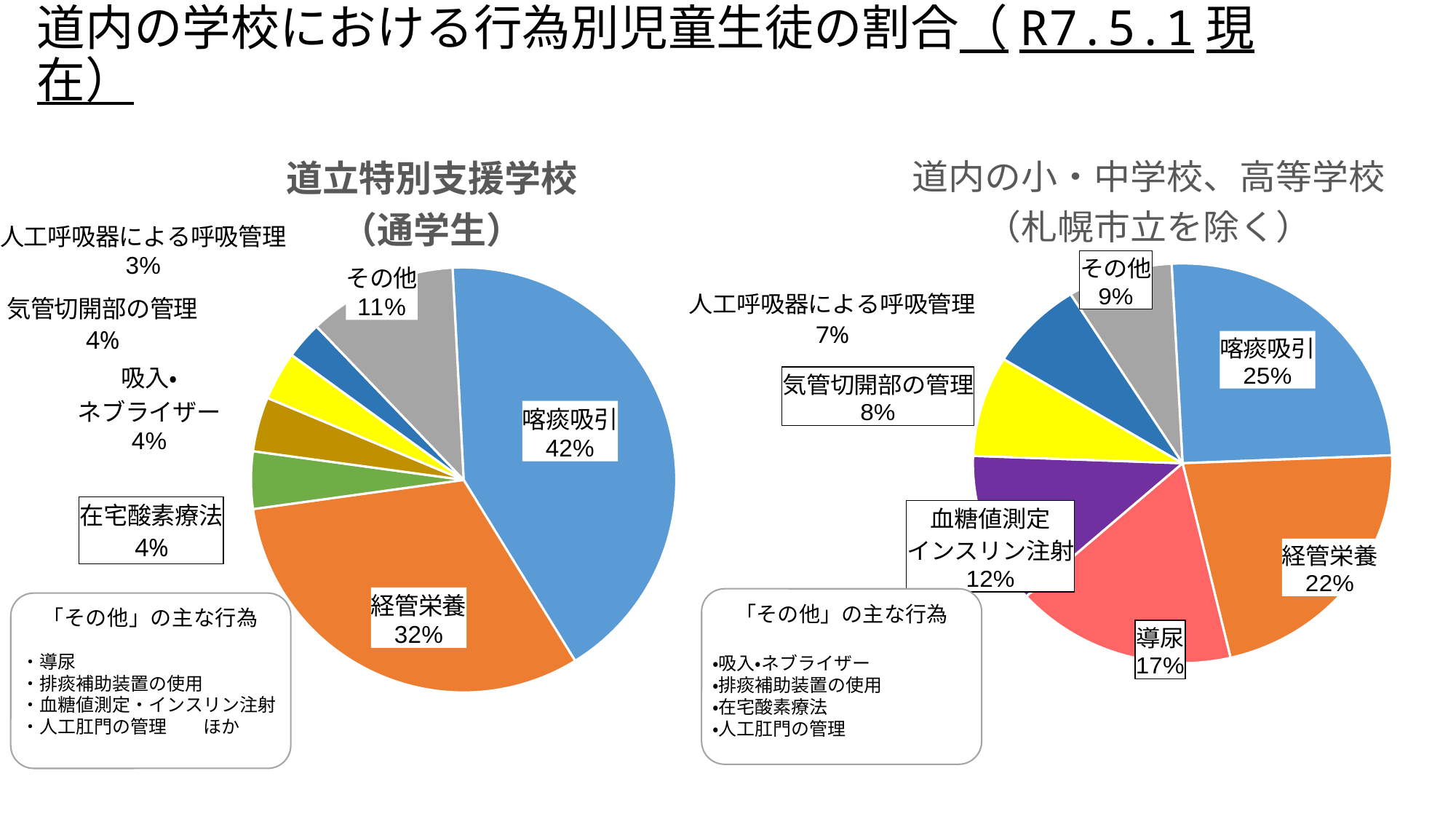
In the left chart (道立特別支援学校（通学生）), which category has the largest share? 喀痰吸引 In the left chart (道立特別支援学校（通学生）), what percentage is shown for 人工呼吸器による呼吸管理? 3% In the left chart (道立特別支援学校（通学生）), what is the difference in percentage points between 喀痰吸引 and 経管栄養? 10 In the left chart (道立特別支援学校（通学生）), what percentage is shown for 経管栄養? 32% How many slices does the right chart (道内の小・中学校、高等学校（札幌市立を除く）) have? 7 In the left chart (道立特別支援学校（通学生）), what percentage is shown for 喀痰吸引? 42% In the left chart (道立特別支援学校（通学生）), which category has the smallest share? 人工呼吸器による呼吸管理 In the right chart (道内の小・中学校、高等学校（札幌市立を除く）), which category has the largest share? 喀痰吸引 In the right chart (道内の小・中学校、高等学校（札幌市立を除く）), what percentage is shown for 血糖値測定インスリン注射? 12% What type of chart is used on this slide? Pie chart In the right chart (道内の小・中学校、高等学校（札幌市立を除く）), which is larger, 気管切開部の管理 or 人工呼吸器による呼吸管理? 気管切開部の管理 In the right chart (道内の小・中学校、高等学校（札幌市立を除く）), what percentage is shown for 導尿? 17%